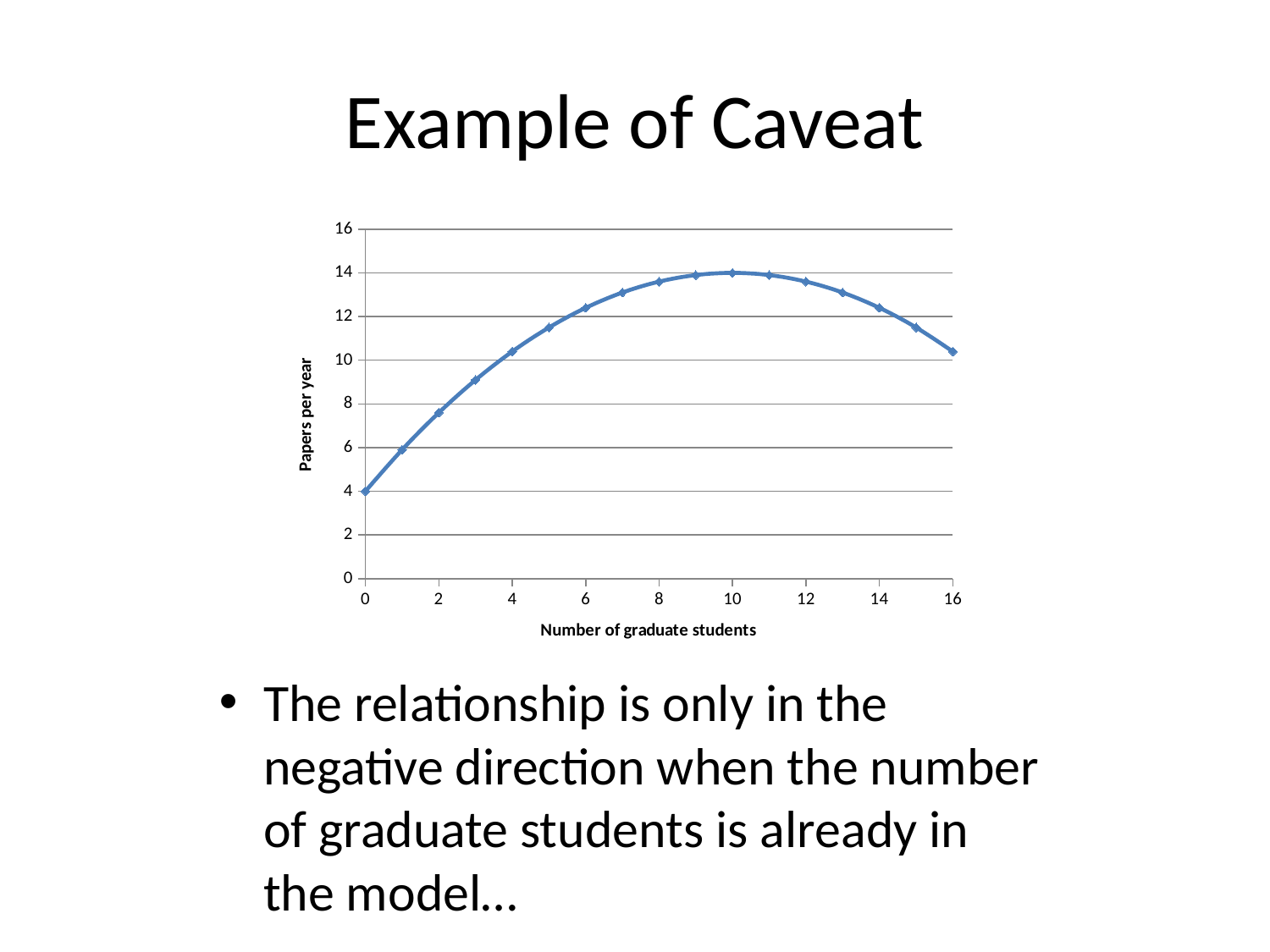
Is the value of papers per year at 4 graduate students greater or less than 8? greater How many data points are plotted on the line? 17 Is the value of papers per year at 16 graduate students greater or less than 12? less What is the value of papers per year when the number of graduate students is 0? 4 At which number of graduate students is papers per year highest? 10 How do papers per year change as the number of graduate students increases from 10 to 16? they fall What is the label of the y axis? Papers per year Which is larger, papers per year at 2 graduate students or at 14 graduate students? 14 graduate students What kind of chart is shown on the slide? line chart What is the value of papers per year when the number of graduate students is 10? 14 What is the label of the x axis? Number of graduate students At which number of graduate students is papers per year lowest? 0